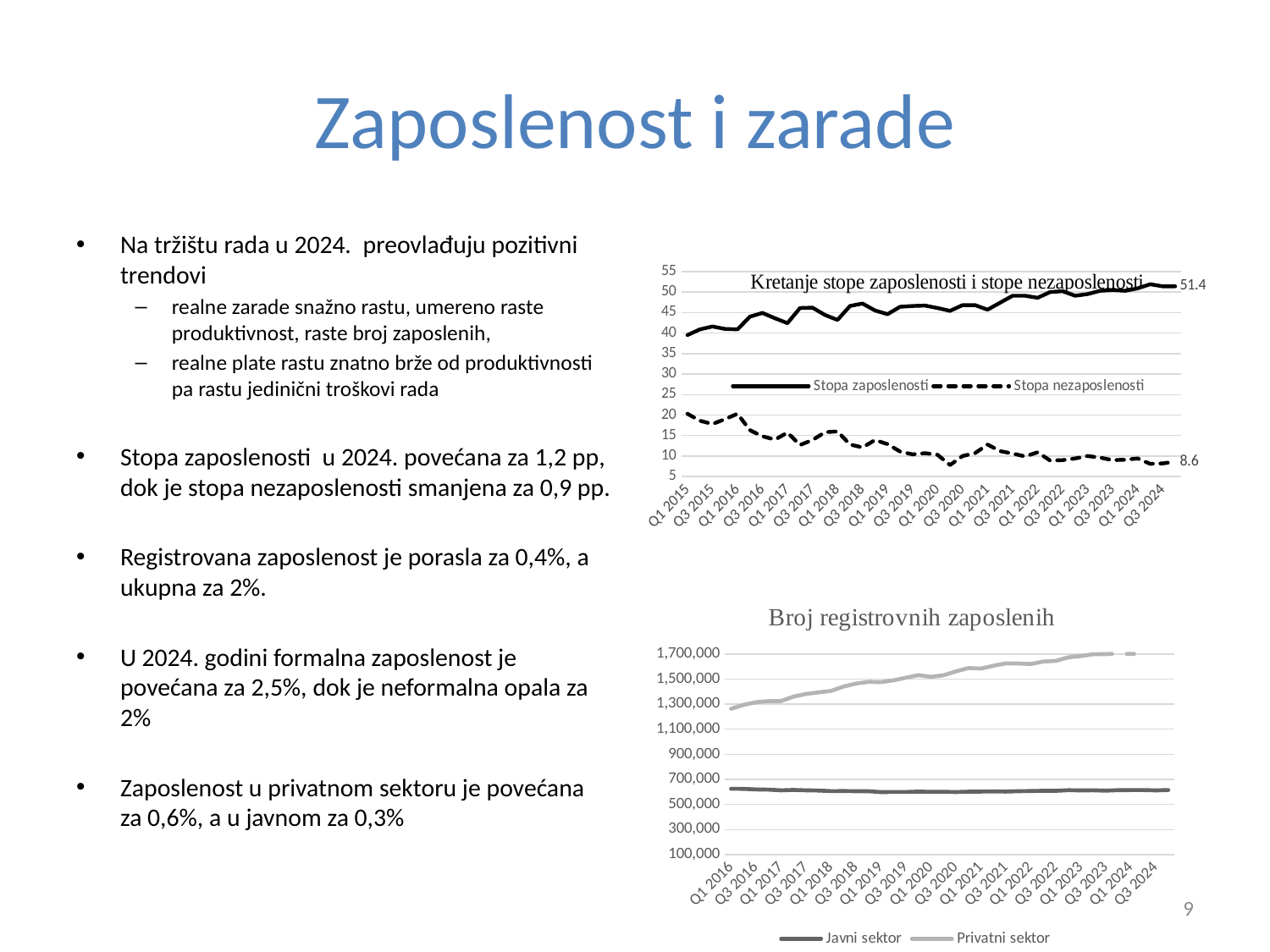
In the top chart 'Kretanje stope zaposlenosti i stope nezaposlenosti', how many series does the legend list? 2 What kind of chart is the bottom chart titled 'Broj registrovnih zaposlenih'? line chart In the top chart 'Kretanje stope zaposlenosti i stope nezaposlenosti', does Stopa nezaposlenosti rise or fall from Q1 2015 to Q3 2024? fall In the top chart 'Kretanje stope zaposlenosti i stope nezaposlenosti', what is the last labelled value of Stopa nezaposlenosti? 8.6 In the top chart 'Kretanje stope zaposlenosti i stope nezaposlenosti', what is the difference between the last labelled values of Stopa zaposlenosti and Stopa nezaposlenosti? 42.8 In the top chart 'Kretanje stope zaposlenosti i stope nezaposlenosti', is the value of Stopa nezaposlenosti at Q1 2015 greater or less than 15? greater In the bottom chart 'Broj registrovnih zaposlenih', how many series does the legend list? 2 In the bottom chart 'Broj registrovnih zaposlenih', which series has the higher values, Javni sektor or Privatni sektor? Privatni sektor What kind of chart is the top chart titled 'Kretanje stope zaposlenosti i stope nezaposlenosti'? line chart In the bottom chart 'Broj registrovnih zaposlenih', is the value for Privatni sektor at Q3 2024 greater or less than 1,500,000? greater In the top chart 'Kretanje stope zaposlenosti i stope nezaposlenosti', what is the last labelled value of Stopa zaposlenosti? 51.4 In the top chart 'Kretanje stope zaposlenosti i stope nezaposlenosti', does Stopa zaposlenosti rise or fall from Q1 2015 to Q3 2024? rise